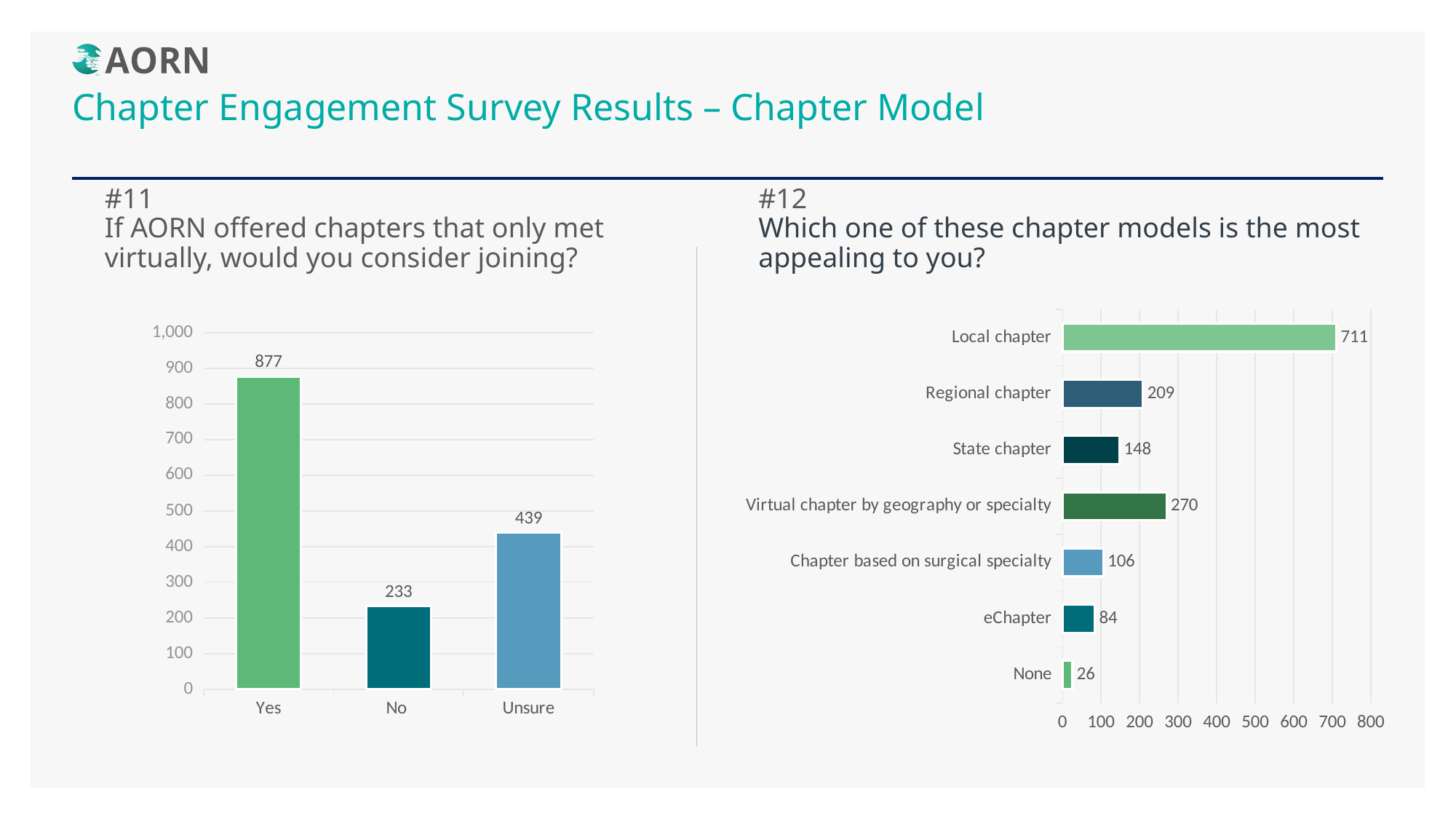
In the #11 chart (left), how many categories are shown? 3 In the #12 chart (right), what is the value for eChapter? 84 In the #12 chart (right), which category has the lowest value? None In the #12 chart (right), what is the difference between Local chapter and Regional chapter? 502 In the #12 chart (right), which is larger: Regional chapter or State chapter? Regional chapter In the #12 chart (right), what is the value for Virtual chapter by geography or specialty? 270 In the #11 chart (left), what is the difference between the Yes and Unsure values? 438 In the #11 chart (left), which category has the lowest value? No In the #12 chart (right), which chapter model has the highest value? Local chapter In the #11 chart (left), what is the value for Yes? 877 In the #11 chart (left), what kind of chart is it? Bar chart In the #12 chart (right), how many chapter models are listed? 7